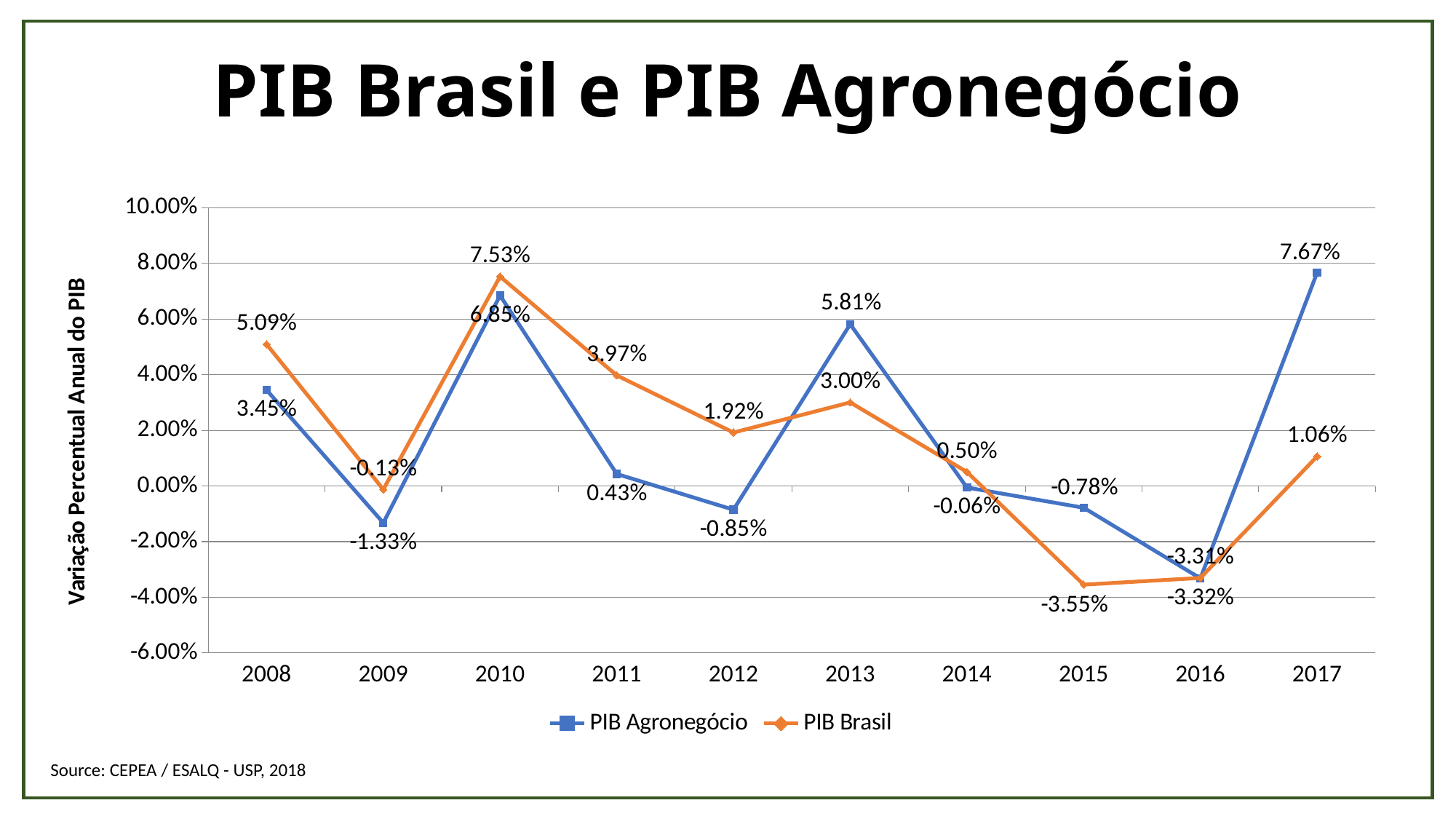
What is the value of PIB Brasil in 2017? 1.06% In 2013, which series has the larger value, PIB Agronegócio or PIB Brasil? PIB Agronegócio In which year does PIB Agronegócio reach its highest value? 2017 What is the value of PIB Agronegócio in 2013? 5.81% In which year does PIB Brasil reach its lowest value? 2015 What is the title of the vertical axis? Variação Percentual Anual do PIB What is the difference between PIB Brasil and PIB Agronegócio in 2010? 0.68% What is the value of PIB Brasil in 2010? 7.53% What kind of chart is shown on the slide? Line chart How many years are shown on the x axis? 10 What is the difference between PIB Brasil and PIB Agronegócio in 2008? 1.64% How many series does the legend list? 2